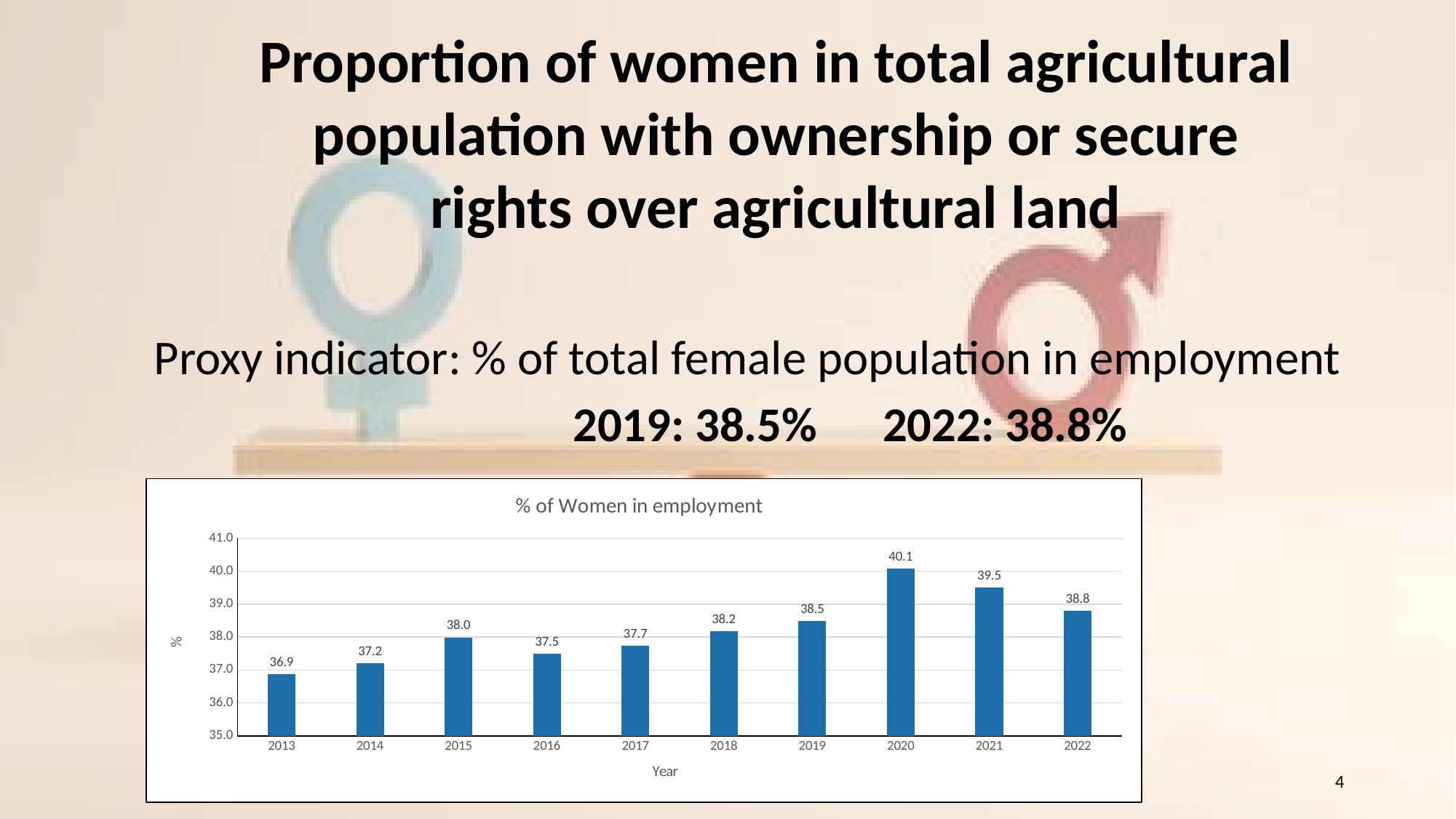
Which year has the lowest value in the chart? 2013 What is the value for 2013 in the chart? 36.9 What kind of chart is shown on the slide? bar chart What is the value for 2020 in the chart? 40.1 Which is larger, the value for 2015 or the value for 2016? 2015 What is the difference between the values for 2021 and 2022? 0.7 Which year has the highest value in the chart? 2020 Is the value for 2019 greater or less than 38.0? greater How many years are shown on the x axis of the chart? 10 What is the title of the chart? % of Women in employment What is the value for 2017 in the chart? 37.7 What is the difference between the values for 2020 and 2013? 3.2